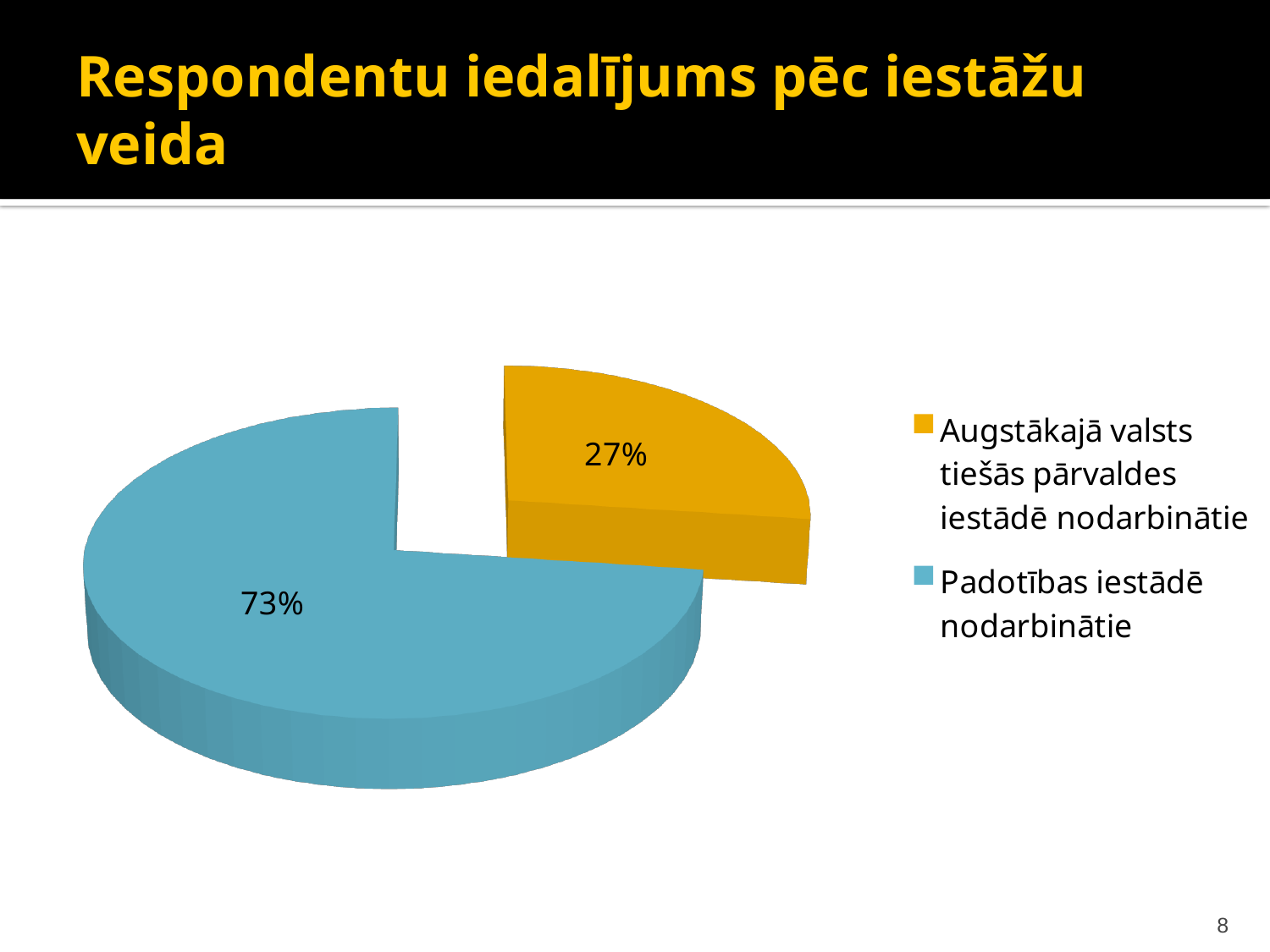
What type of chart is shown on the slide? pie chart What share of respondents are 'Padotības iestādē nodarbinātie'? 73% Which category has the largest slice of the pie? Padotības iestādē nodarbinātie How many categories does the pie chart show? 2 Which category has the smallest slice of the pie? Augstākajā valsts tiešās pārvaldes iestādē nodarbinātie What colour is the slice for 'Augstākajā valsts tiešās pārvaldes iestādē nodarbinātie'? yellow/gold What is the difference in percentage points between the 'Padotības iestādē nodarbinātie' slice and the 'Augstākajā valsts tiešās pārvaldes iestādē nodarbinātie' slice? 46 percentage points Is the share for 'Padotības iestādē nodarbinātie' greater or less than 50%? greater What is the title of the slide containing the chart? Respondentu iedalījums pēc iestāžu veida How many entries does the legend list? 2 Which is larger: the share for 'Augstākajā valsts tiešās pārvaldes iestādē nodarbinātie' or for 'Padotības iestādē nodarbinātie'? Padotības iestādē nodarbinātie What share of respondents are 'Augstākajā valsts tiešās pārvaldes iestādē nodarbinātie'? 27%